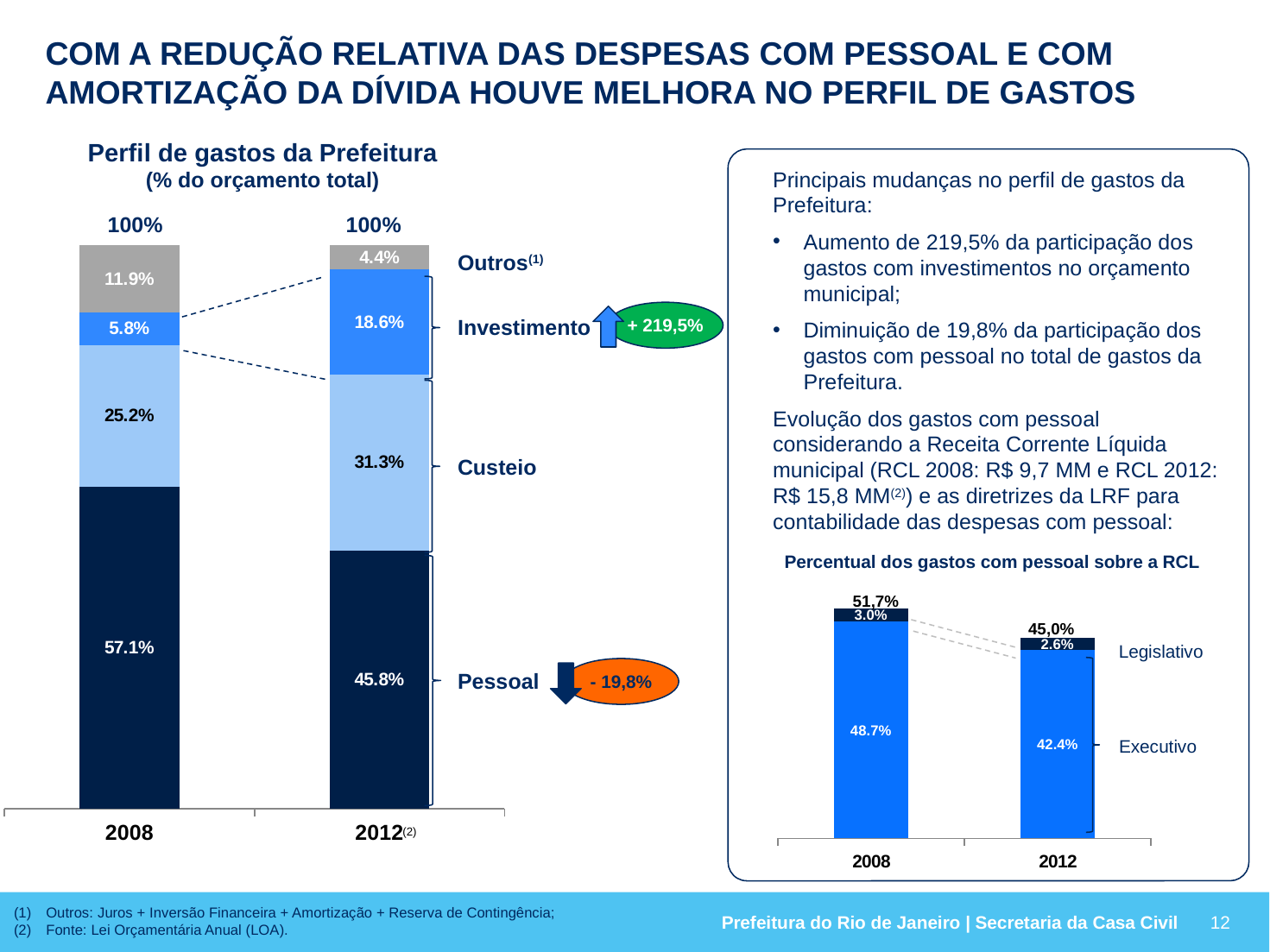
In the chart 'Percentual dos gastos com pessoal sobre a RCL', what is the value for Executivo in 2012? 42.4% What kind of chart is 'Percentual dos gastos com pessoal sobre a RCL'? Stacked bar chart In the chart 'Perfil de gastos da Prefeitura', what is the value for Investimento in 2012? 18.6% In the chart 'Perfil de gastos da Prefeitura', what is the value for Outros in 2008? 11.9% In the chart 'Perfil de gastos da Prefeitura', which segment is the smallest in the 2012 bar? Outros In the chart 'Percentual dos gastos com pessoal sobre a RCL', what is the difference between the Legislativo values for 2008 and 2012? 0.4% In the chart 'Percentual dos gastos com pessoal sobre a RCL', what is the total of the 2008 bar? 51,7% In the chart 'Perfil de gastos da Prefeitura', what is the difference between the Custeio values for 2012 and 2008? 6.1% In the chart 'Perfil de gastos da Prefeitura', which segment is the largest in the 2012 bar? Pessoal In the chart 'Perfil de gastos da Prefeitura', is the Investimento value larger in 2008 or in 2012? 2012 In the chart 'Perfil de gastos da Prefeitura', what is the value for Pessoal in 2008? 57.1% In the chart 'Perfil de gastos da Prefeitura', how many segments make up each stacked bar? 4